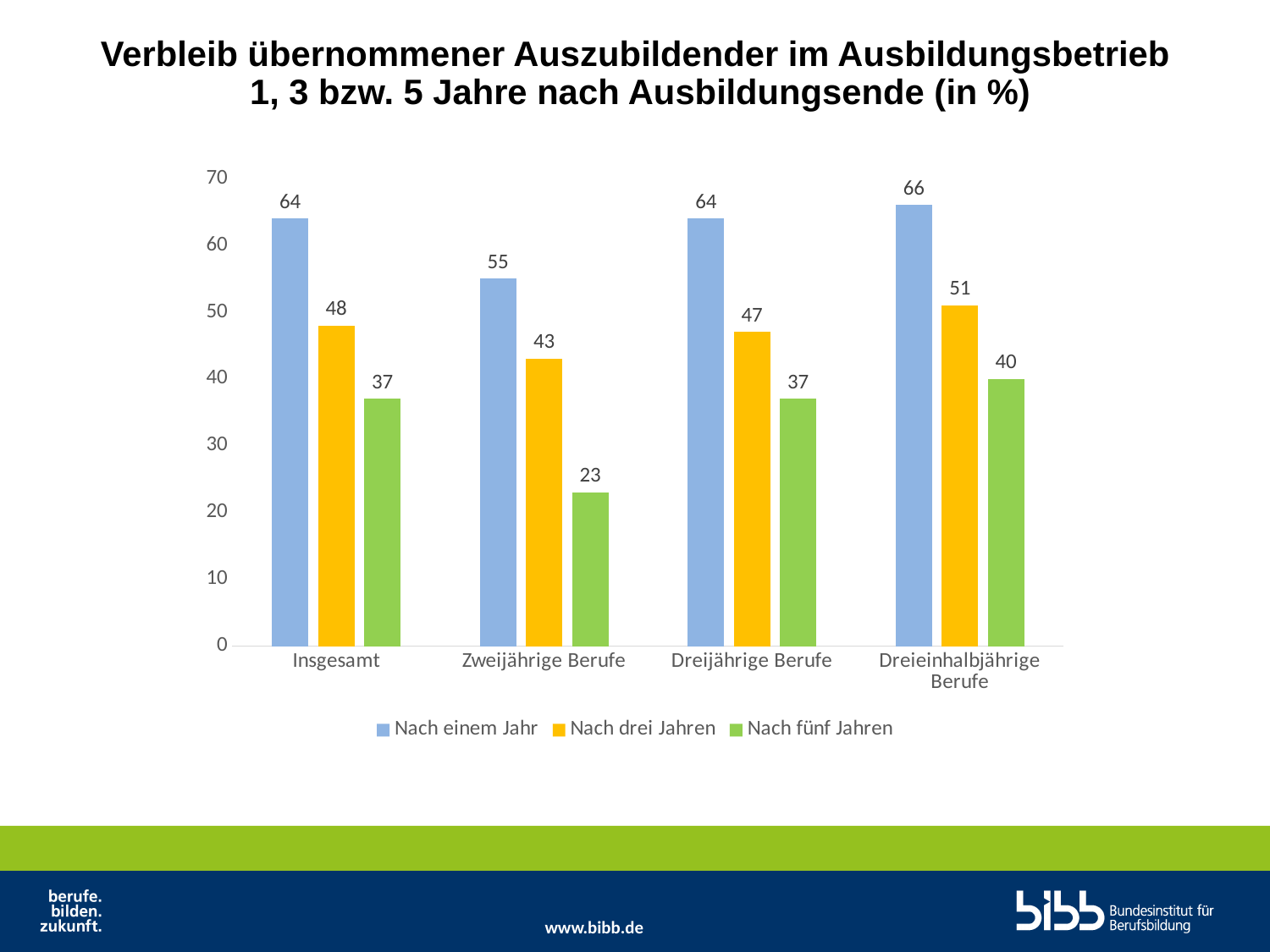
What is the value for Insgesamt in the Nach drei Jahren series? 48 Which category has the lowest value in the Nach fünf Jahren series? Zweijährige Berufe What is the value for Dreieinhalbjährige Berufe in the Nach fünf Jahren series? 40 Which category has the highest value in the Nach einem Jahr series? Dreieinhalbjährige Berufe What is the difference between the Nach einem Jahr and Nach fünf Jahren values for Zweijährige Berufe? 32 What kind of chart is shown on the slide? Bar chart How many series does the legend list? 3 Which colour represents the Nach drei Jahren series? Yellow How many categories are shown on the x axis? 4 What is the value for Zweijährige Berufe in the Nach einem Jahr series? 55 Within each category, do the values rise or fall from Nach einem Jahr to Nach fünf Jahren? Fall Which is larger: the Nach drei Jahren value for Dreijährige Berufe or for Dreieinhalbjährige Berufe? Dreieinhalbjährige Berufe